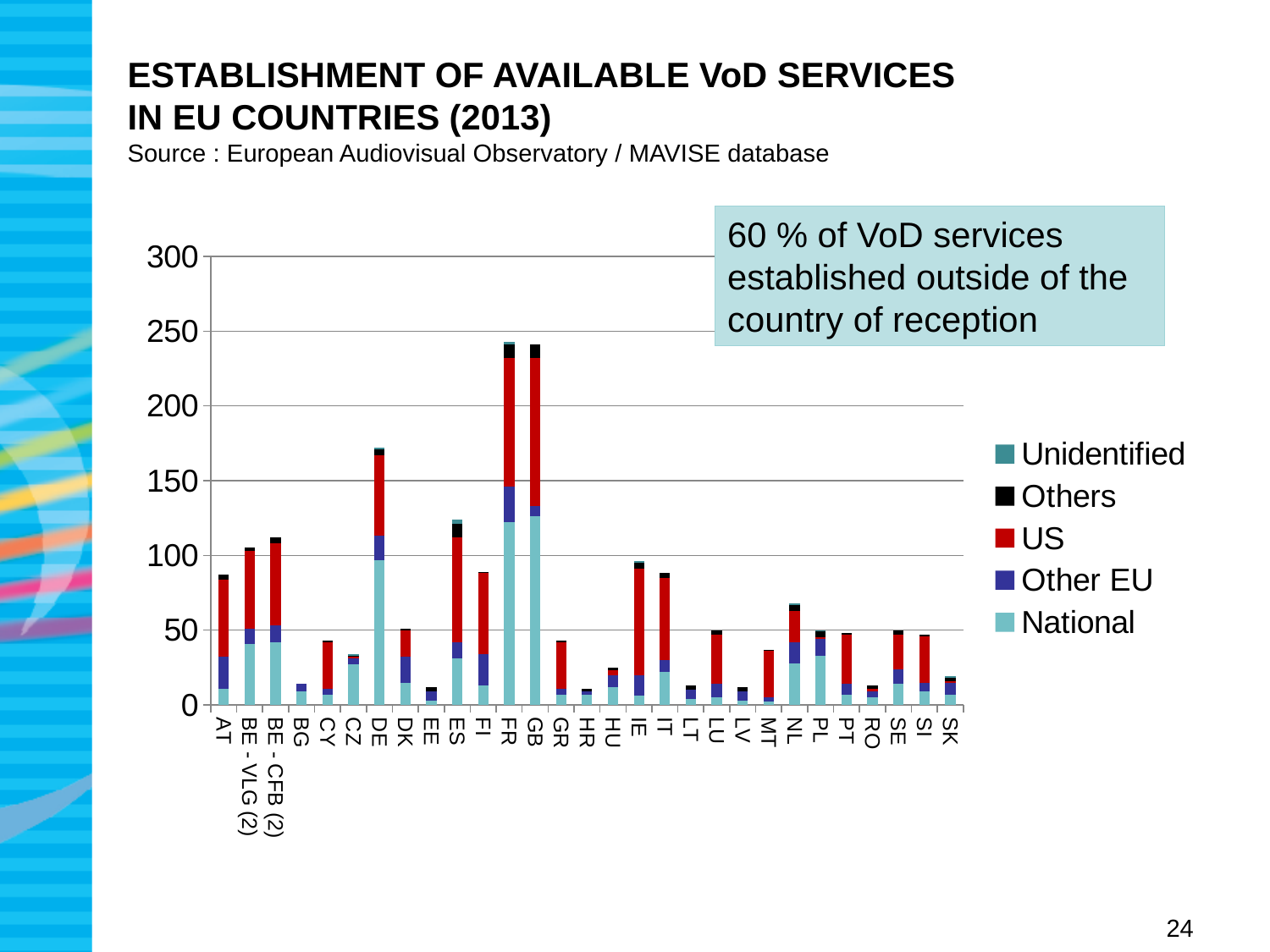
Which has the taller stacked bar, AT or BG? AT Is the total value for AT greater or less than 100? less How many countries (categories) are shown on the x axis? 29 How many series does the legend list? 5 Is the total value for MT greater or less than 50? less Which has the taller stacked bar, DE or ES? DE Is the total value for ES greater or less than 100? greater What kind of chart is shown on the slide? Stacked bar chart Which legend entry is shown in red? US